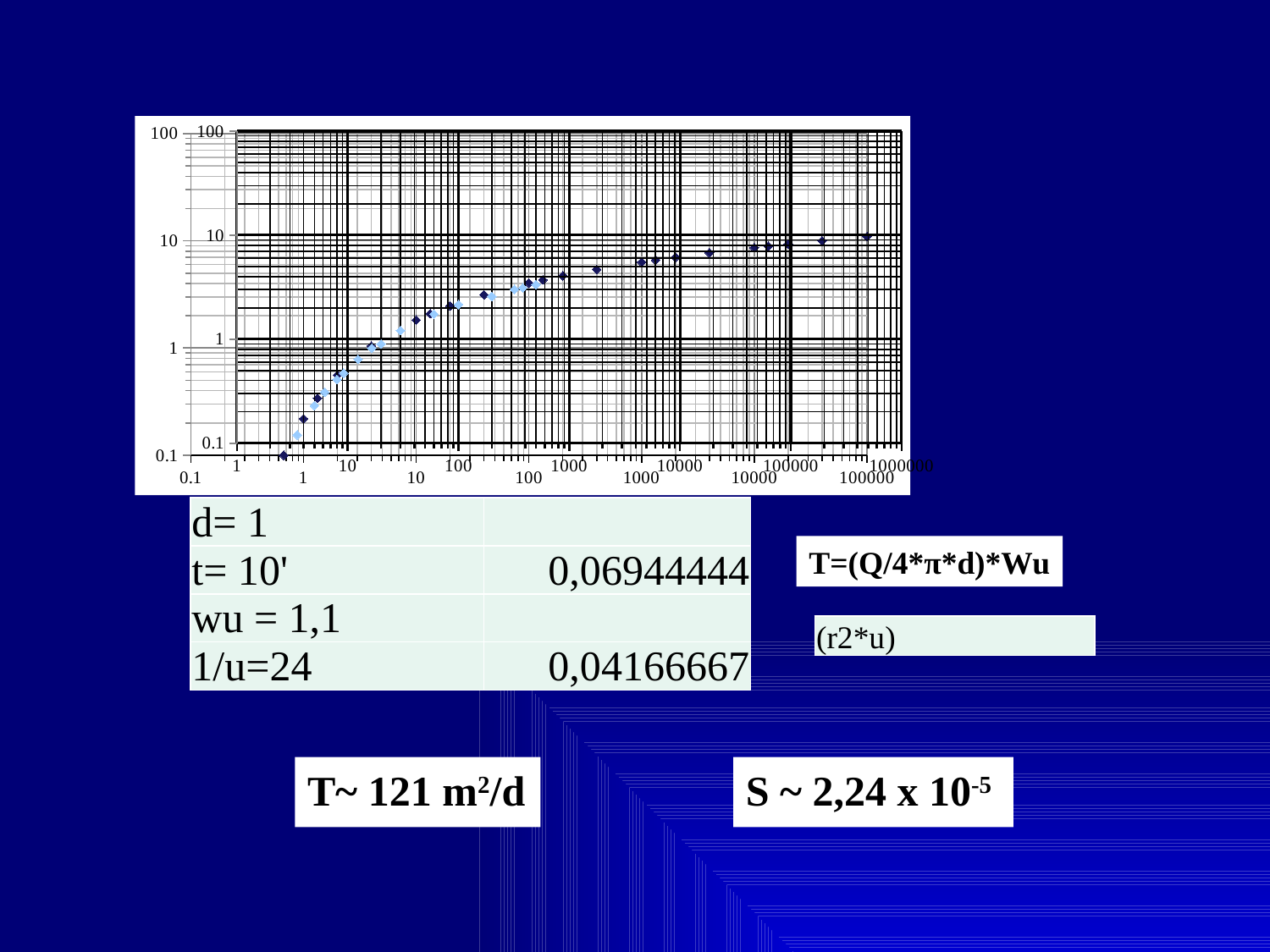
What is the highest tick label shown on the y axis of the chart? 100 What is the lowest tick label shown on the x axis of the chart? 0.1 Do the plotted values rise or fall as you move from left to right along the x axis? rise What kind of chart is shown on the slide? scatter chart Are the plotted points at the far right of the chart greater or less than 1 on the y axis? greater Are the plotted points at the far left of the chart greater or less than 1 on the y axis? less